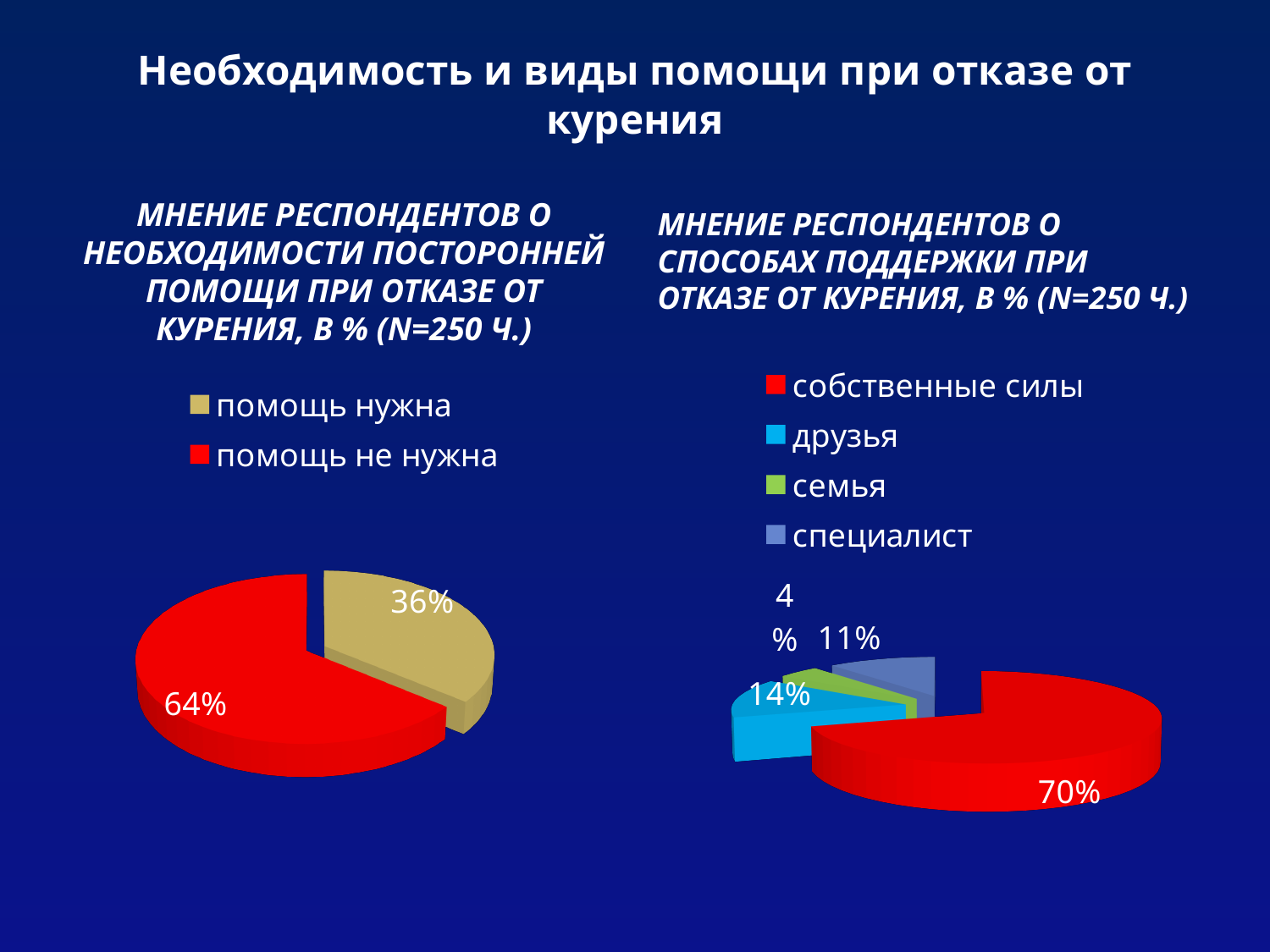
On the right chart, what colour represents "собственные силы"? red On the right chart, how many categories does the legend list? 4 What type of chart is the left chart? pie chart On the right chart, what percentage corresponds to "собственные силы"? 70% On the left chart, what percentage of respondents answered "помощь не нужна"? 64% On the left chart, what percentage of respondents answered "помощь нужна"? 36% On the left chart, what is the difference in percentage points between "помощь не нужна" and "помощь нужна"? 28 On the right chart, which category has the smallest share? семья On the right chart, which is larger: "друзья" or "специалист"? друзья On the right chart, what percentage corresponds to "специалист"? 11% On the right chart, what percentage corresponds to "друзья"? 14% On the left chart, which category has the larger share? помощь не нужна